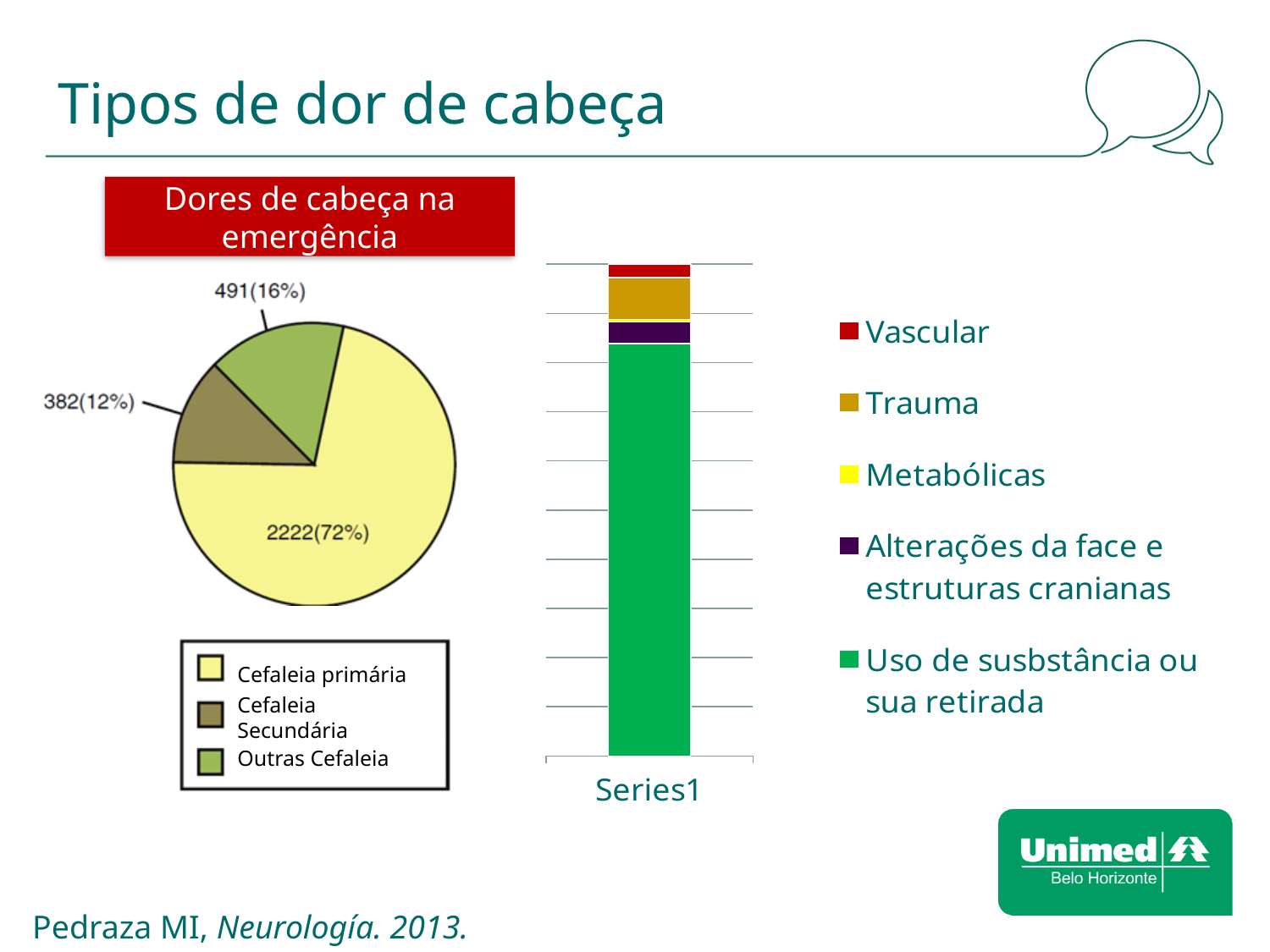
In the pie chart on the left, what share of the pie does Outras Cefaleia represent? 16% In the pie chart on the left, what value is shown for Outras Cefaleia? 491(16%) What kind of chart is the chart on the left of the slide? Pie chart In the stacked bar chart in the middle of the slide, how many series does the legend list? 5 What kind of chart is the chart in the middle of the slide with the Series1 label? Stacked bar chart In the pie chart on the left, what value is shown for Cefaleia Secundária? 382(12%) In the pie chart on the left, which category has the smallest slice? Cefaleia Secundária In the pie chart on the left, what is the difference in count between Cefaleia primária and Cefaleia Secundária? 1840 In the stacked bar chart in the middle of the slide, which series occupies the largest segment of the bar? Uso de susbstância ou sua retirada In the pie chart on the left, which category has the largest slice? Cefaleia primária In the pie chart on the left, what value is shown for Cefaleia primária? 2222(72%) In the pie chart on the left, how many categories are shown? 3